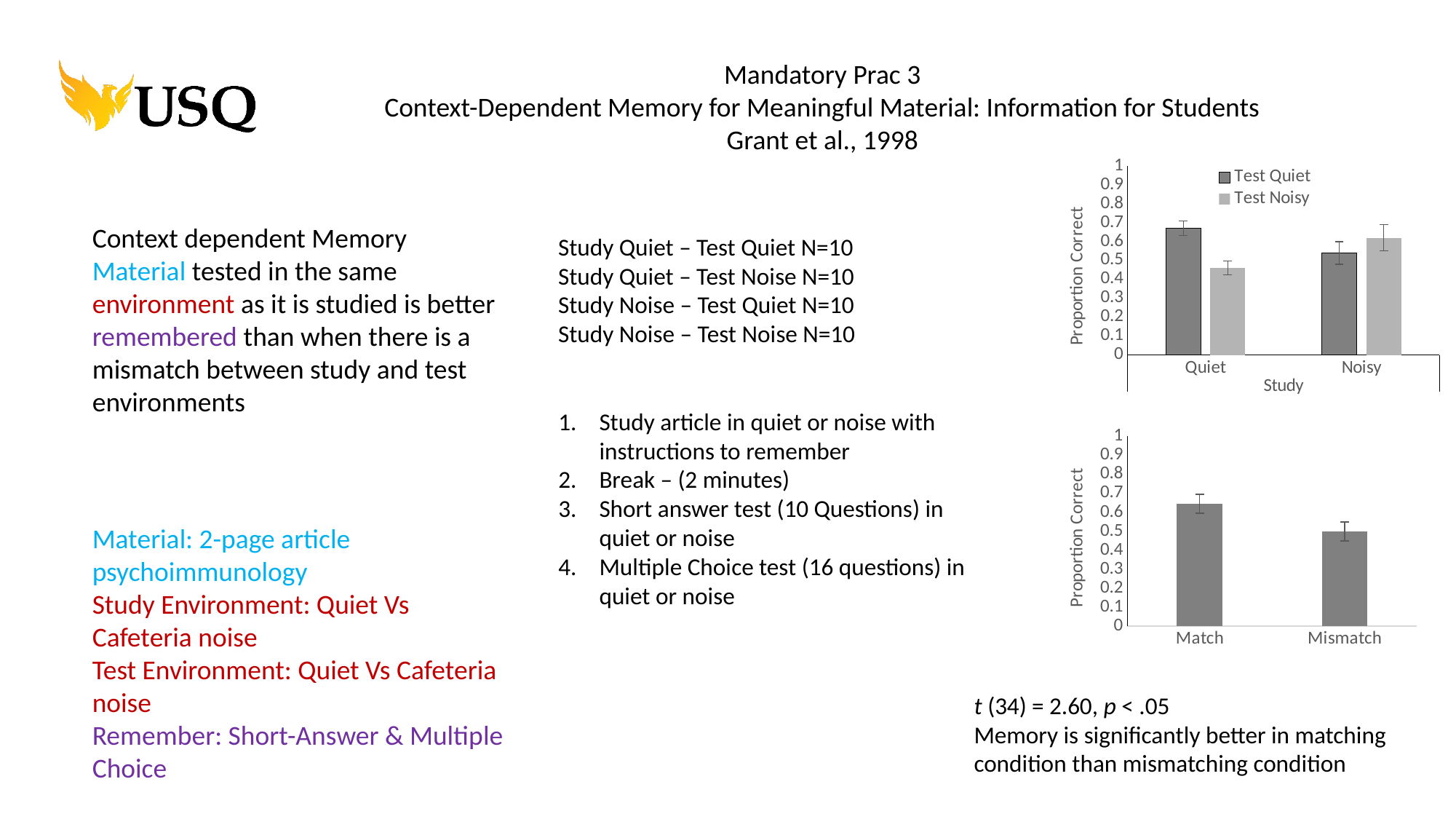
What kind of chart is the top chart on the right of the slide? bar chart In the top chart, how many study categories are shown on the x axis? 2 In the top chart, what are the two series named in the legend? Test Quiet and Test Noisy In the top chart, is the Test Noisy value for the Quiet study condition greater or less than 0.6? less How many series does the legend of the top chart list? 2 In the top chart, for the Noisy study condition, which is larger: Test Quiet or Test Noisy? Test Noisy In the top chart, which bar is the lowest? Test Noisy for the Quiet study condition In the top chart, for the Quiet study condition, which is larger: Test Quiet or Test Noisy? Test Quiet In the bottom chart, is the value for Mismatch greater or less than 0.6? less What is the y-axis title of the bottom chart? Proportion Correct In the top chart, is the Test Quiet value for the Quiet study condition greater or less than 0.6? greater In the bottom chart, which is larger: Match or Mismatch? Match